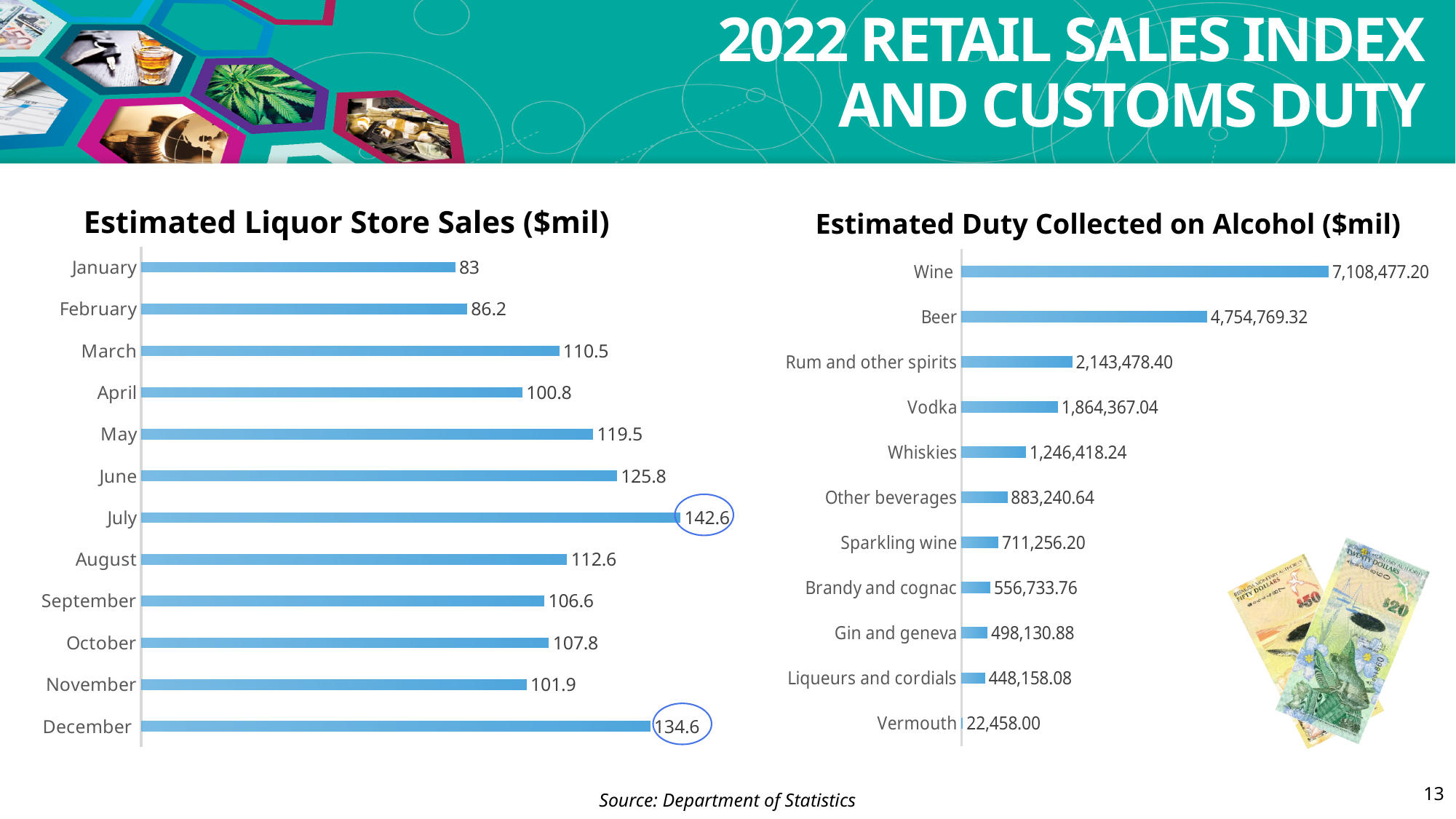
In the 'Estimated Liquor Store Sales ($mil)' chart, which month has the lowest value? January In the 'Estimated Liquor Store Sales ($mil)' chart, what is the value for July? 142.6 In the 'Estimated Duty Collected on Alcohol ($mil)' chart, which category has the highest value? Wine How many months are shown in the 'Estimated Liquor Store Sales ($mil)' chart? 12 How many categories are shown in the 'Estimated Duty Collected on Alcohol ($mil)' chart? 11 In the 'Estimated Duty Collected on Alcohol ($mil)' chart, which category has the lowest value? Vermouth In the 'Estimated Liquor Store Sales ($mil)' chart, what is the difference between the values for December and January? 51.6 What type of chart is the 'Estimated Duty Collected on Alcohol ($mil)' chart? Bar chart In the 'Estimated Liquor Store Sales ($mil)' chart, which is larger, the value for March or the value for April? March In the 'Estimated Duty Collected on Alcohol ($mil)' chart, what is the value for Sparkling wine? 711,256.20 In the 'Estimated Liquor Store Sales ($mil)' chart, which month has the highest value? July In the 'Estimated Duty Collected on Alcohol ($mil)' chart, what is the value for Beer? 4,754,769.32